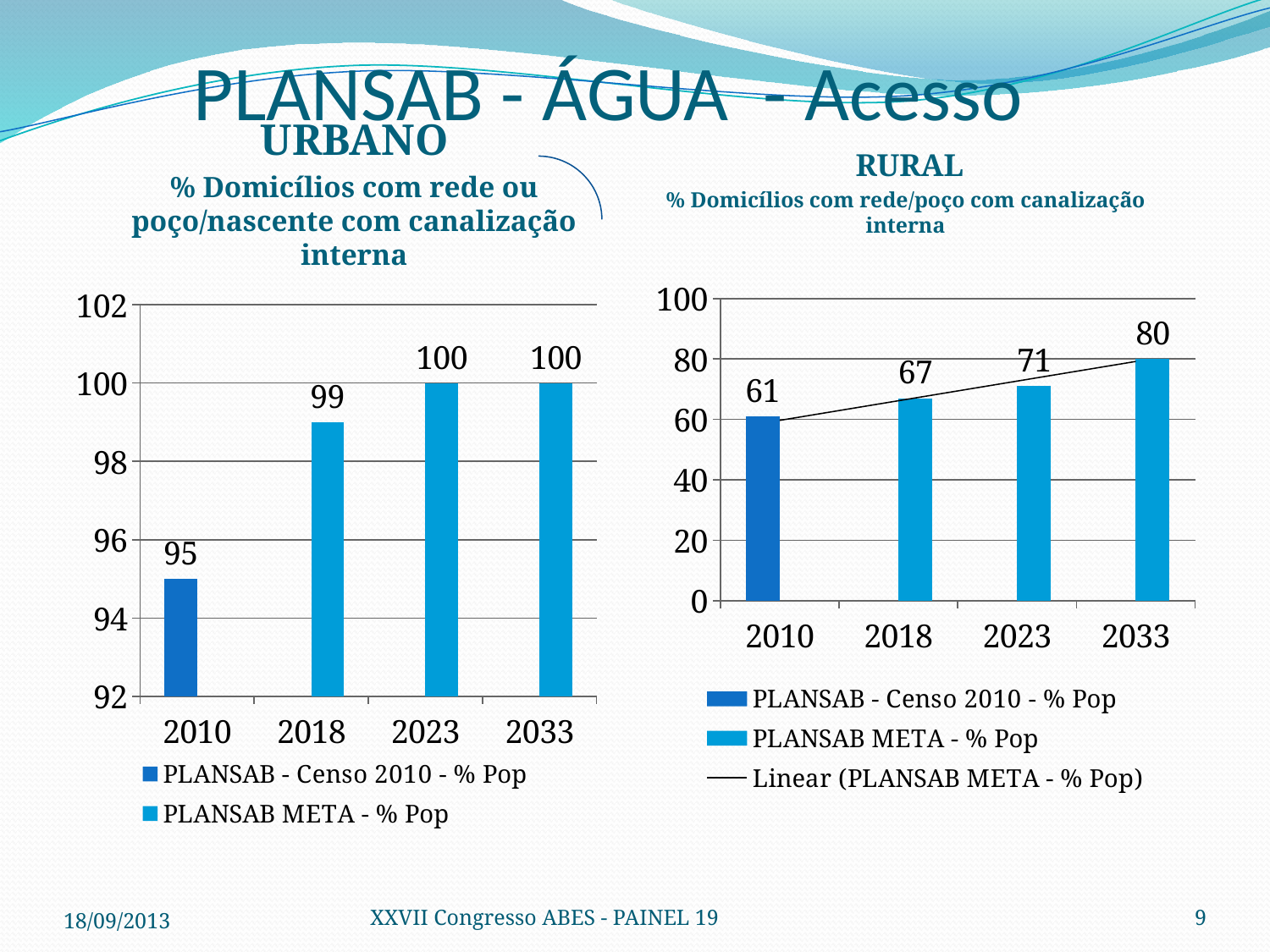
In the URBANO chart on the left, which year has the lowest value? 2010 How many years are shown on the x axis of the URBANO chart on the left? 4 In the RURAL chart on the right, which is larger, the value for 2018 or the value for 2023? 2023 In the RURAL chart on the right, which year has the lowest value? 2010 In the URBANO chart on the left, what is the value for 2010? 95 How many entries does the legend of the RURAL chart on the right list? 3 Do the values in the RURAL chart on the right rise or fall from 2010 to 2033? rise In the RURAL chart on the right, what is the difference between the values for 2033 and 2010? 19 In the RURAL chart on the right, what is the value for 2023? 71 In the URBANO chart on the left, what is the value for 2018? 99 In the RURAL chart on the right, what is the value for 2033? 80 In the URBANO chart on the left, what is the difference between the values for 2018 and 2010? 4